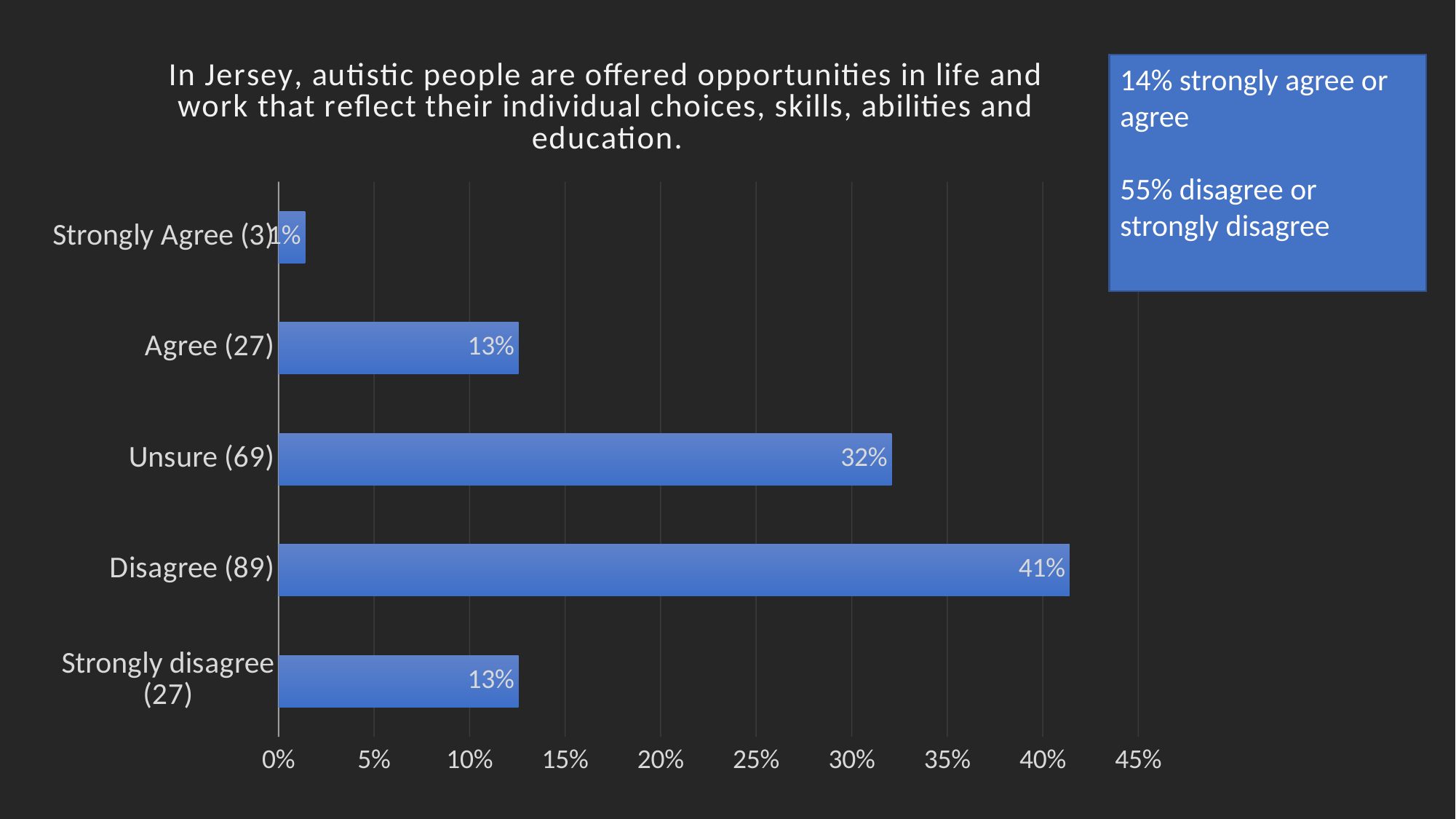
What kind of chart is shown on the slide? Bar chart What is the difference in percentage points between Disagree (89) and Unsure (69)? 9 Which category has the lowest percentage? Strongly Agree (3) According to the text box on the slide, what percentage disagree or strongly disagree? 55% What percentage is shown for Unsure (69)? 32% What percentage is shown for Agree (27)? 13% How many categories are shown in the chart? 5 Is the value for Disagree (89) greater or less than 40%? greater What percentage is shown for Disagree (89)? 41% Which category has the highest percentage? Disagree (89) What percentage is shown for Strongly Agree (3)? 1% Which is larger, the value for Unsure (69) or the value for Strongly disagree (27)? Unsure (69)